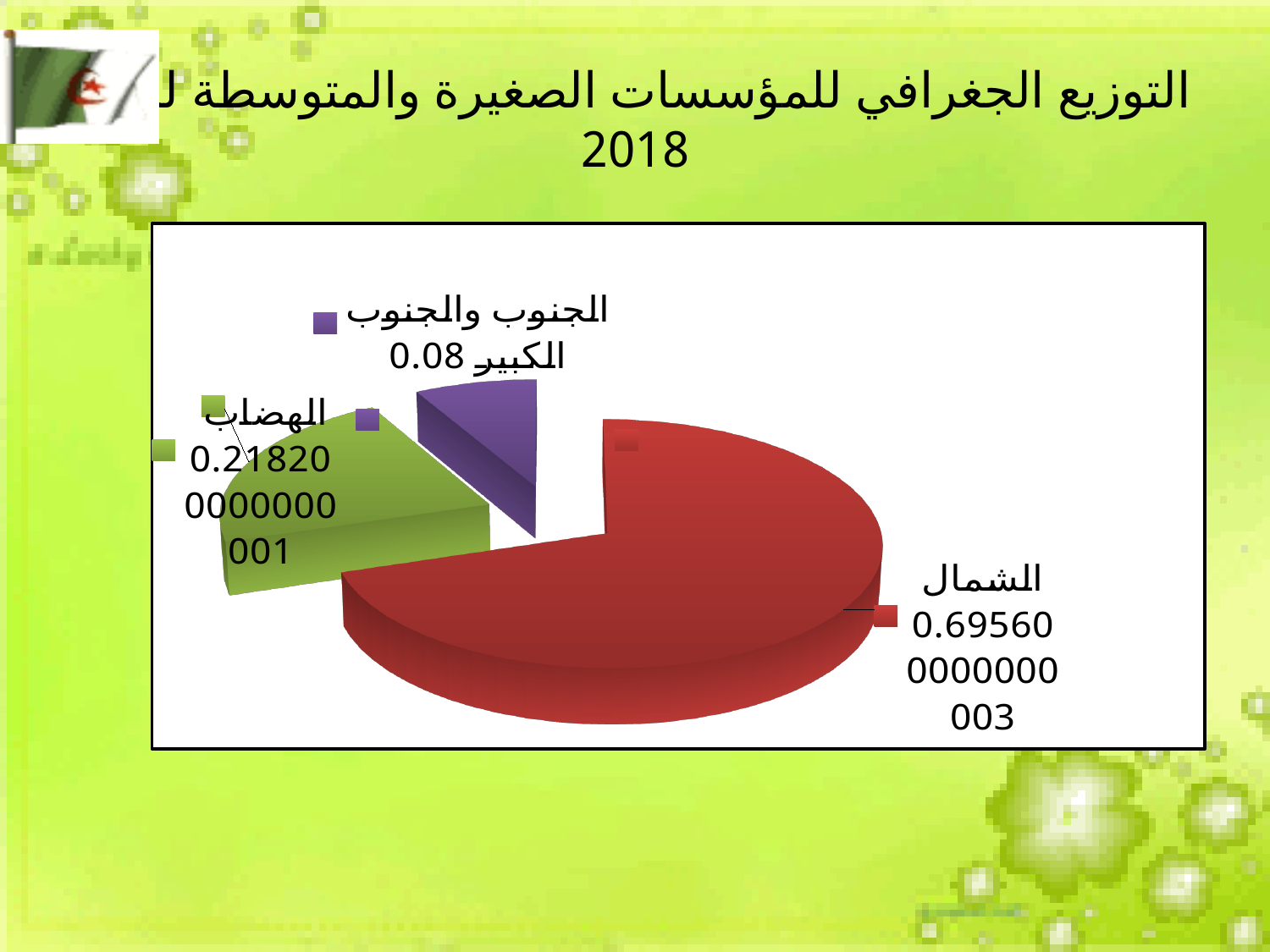
Which is larger, the value for الهضاب or the value for الجنوب والجنوب الكبير? الهضاب Which category has the smallest slice of the pie? الجنوب والجنوب الكبير How many slices does the pie chart have? 3 What is the difference between the value for الهضاب and the value for الجنوب والجنوب الكبير? 0.138200000000001 What is the value shown for الجنوب والجنوب الكبير? 0.08 Which year is mentioned in the slide title? 2018 What is the value shown for الشمال? 0.695600000000003 What kind of chart is shown on the slide? pie chart What colour is the slice for الشمال? red Which category has the largest slice of the pie? الشمال What is the value shown for الهضاب? 0.218200000000001